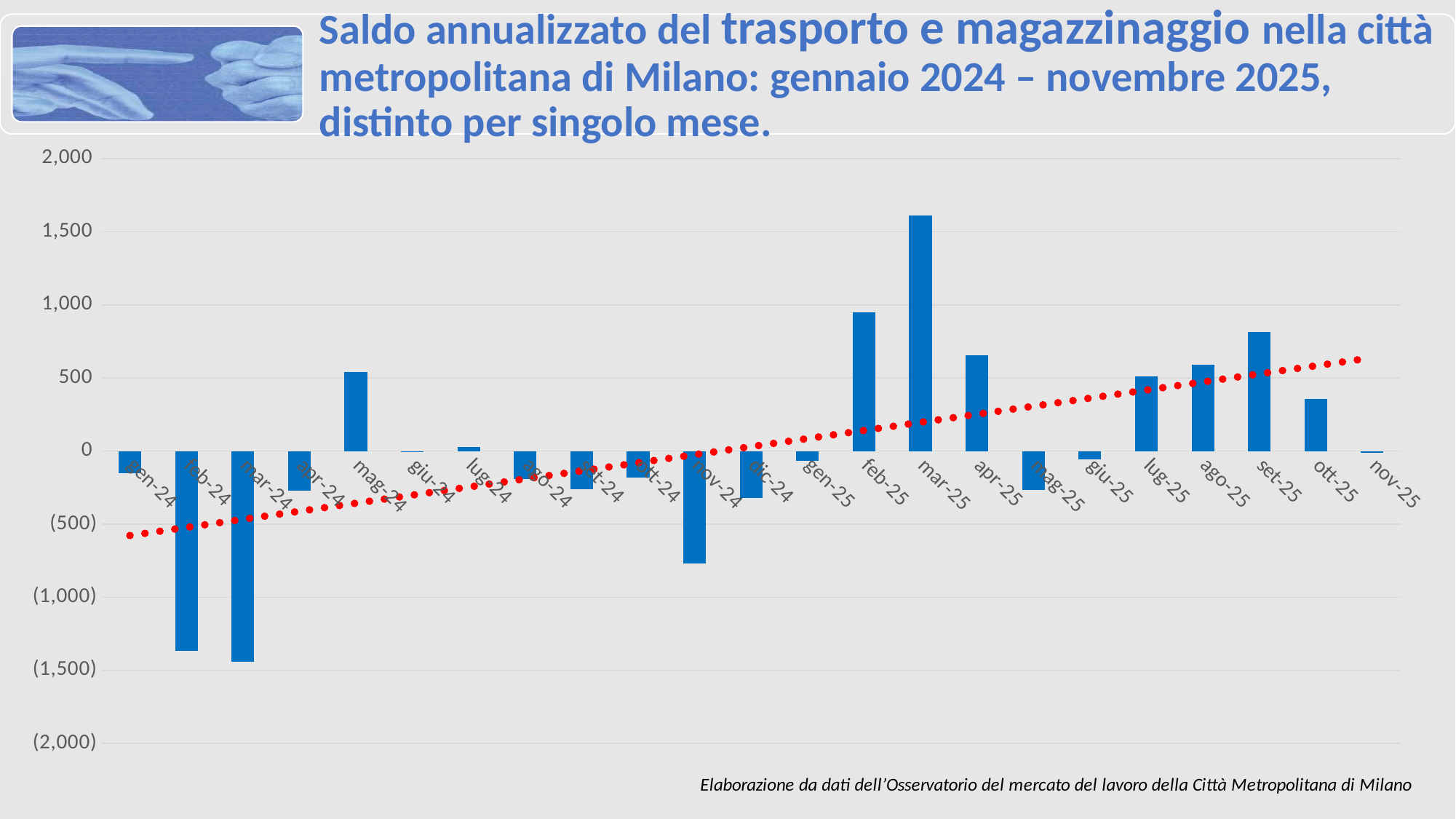
What colour is the dotted trend line? red Is the value for feb-25 greater or less than 1,000? less Does the dotted trend line rise or fall from gen-24 to nov-25? rises Which is larger, the value for feb-25 or the value for set-25? feb-25 Is the value for nov-24 greater or less than -500? less Which month has the highest value? mar-25 Is the value for set-25 greater or less than 500? greater How many months are plotted on the x axis? 23 Which month has the lowest value? mar-24 What kind of chart is shown on the slide? bar chart